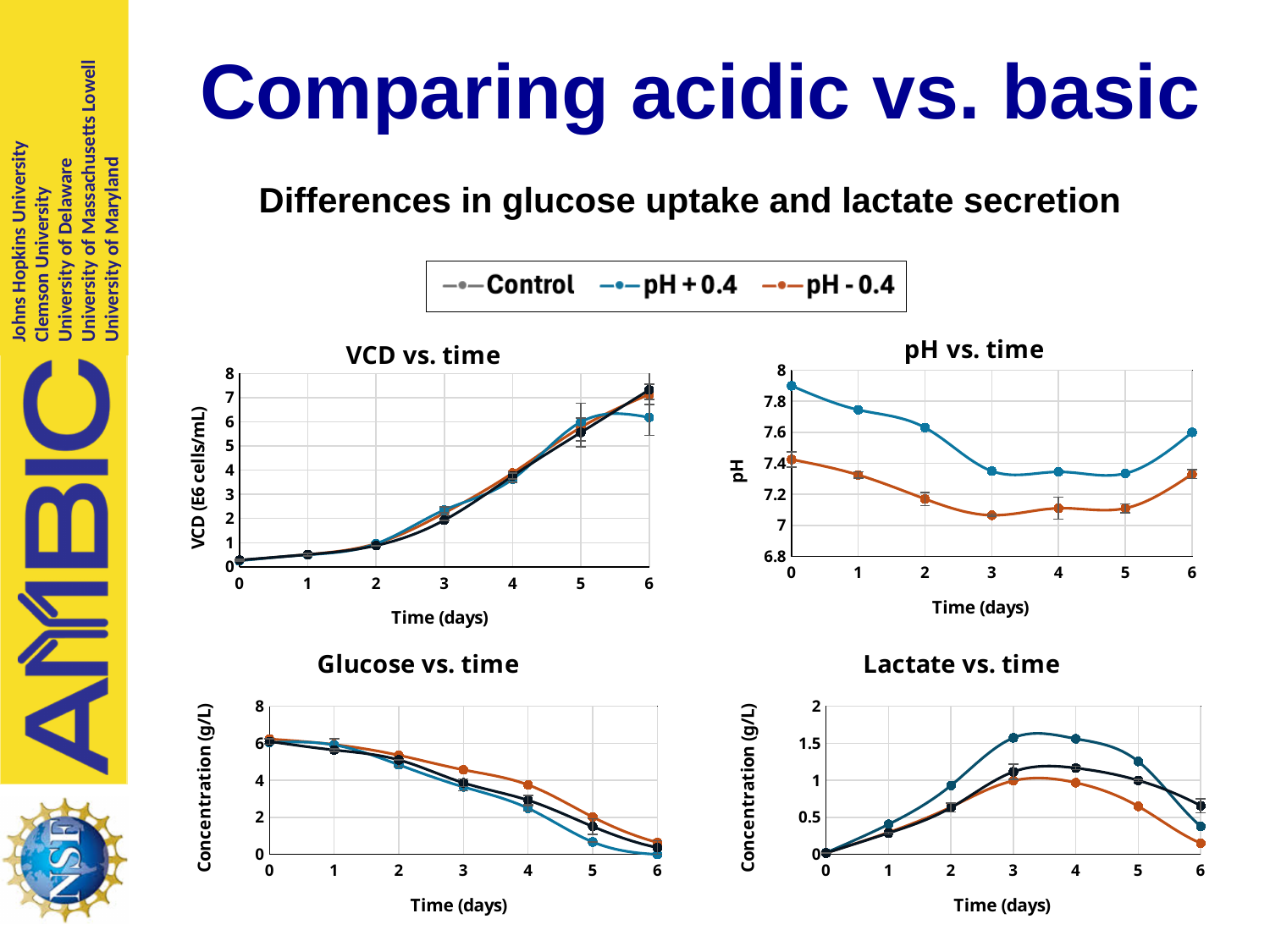
How many series does the legend at the top of the slide list? 3 In the 'VCD vs. time' chart, is the pH + 0.4 value at day 6 greater or less than 7? less What is the y-axis label of the 'VCD vs. time' chart? VCD (E6 cells/mL) In the 'pH vs. time' chart, how many time points are plotted along the x axis? 7 In the 'Lactate vs. time' chart, is the pH + 0.4 value at day 3 greater or less than 1.5? greater In the 'pH vs. time' chart, is the pH + 0.4 value at day 0 greater or less than 7.8? greater In the 'Glucose vs. time' chart, do the values rise or fall from day 0 to day 6? fall What kind of chart is the 'VCD vs. time' chart? line chart In the 'pH vs. time' chart, which series has the higher value at day 2, pH + 0.4 or pH - 0.4? pH + 0.4 In the 'Glucose vs. time' chart, which series has the lowest value at day 5? pH + 0.4